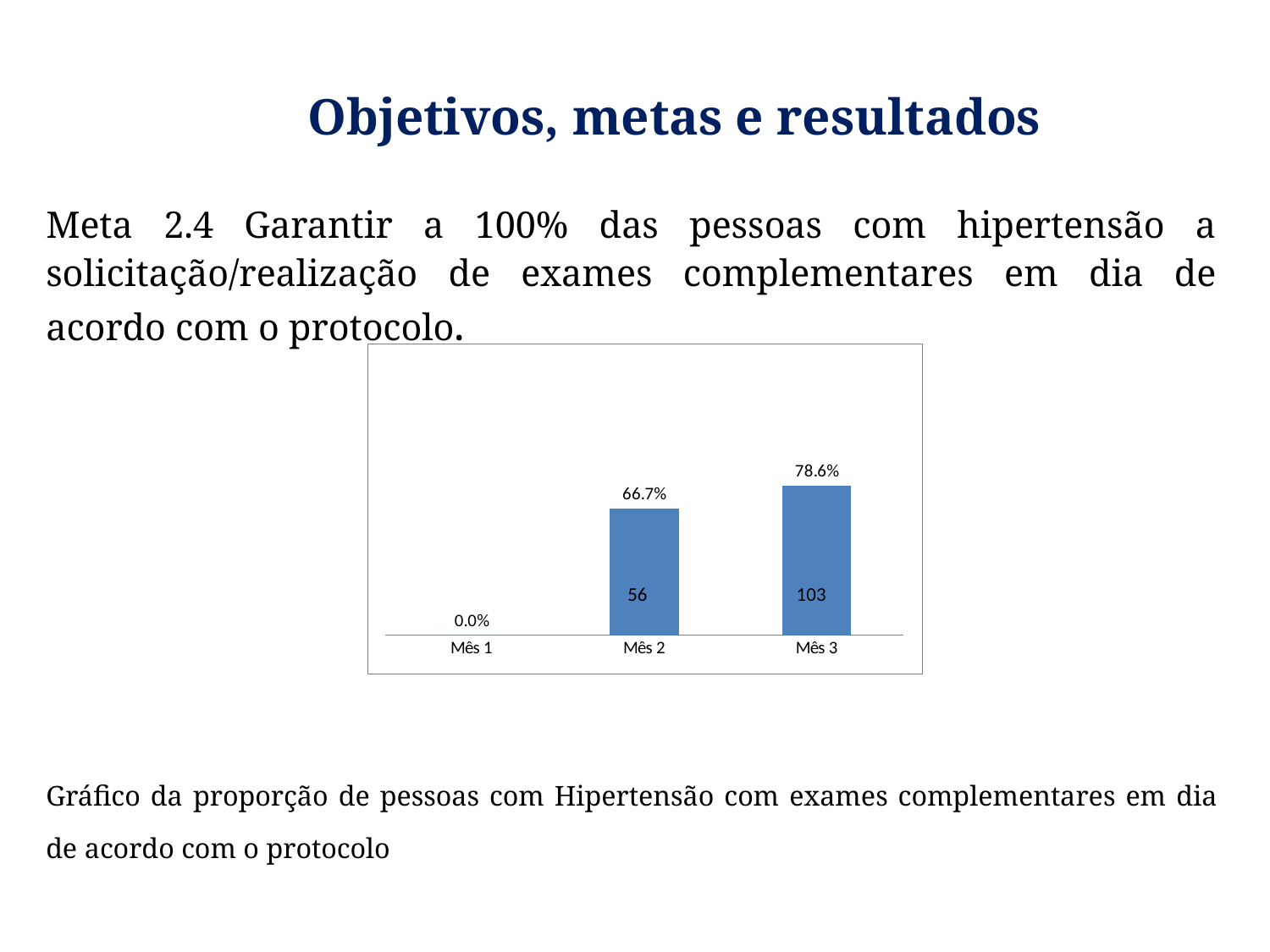
How many months are shown on the x axis? 3 What percentage is shown for Mês 3? 78.6% Which month has the lowest percentage? Mês 1 What number is printed inside the bar for Mês 2? 56 What is the difference in percentage points between Mês 3 and Mês 2? 11.9 What kind of chart is shown on the slide? Bar chart Which is larger, the percentage for Mês 2 or for Mês 3? Mês 3 What percentage is shown for Mês 1? 0.0% What percentage is shown for Mês 2? 66.7% What number is printed inside the bar for Mês 3? 103 Do the percentages rise or fall from Mês 1 to Mês 3? Rise Which month has the highest percentage? Mês 3